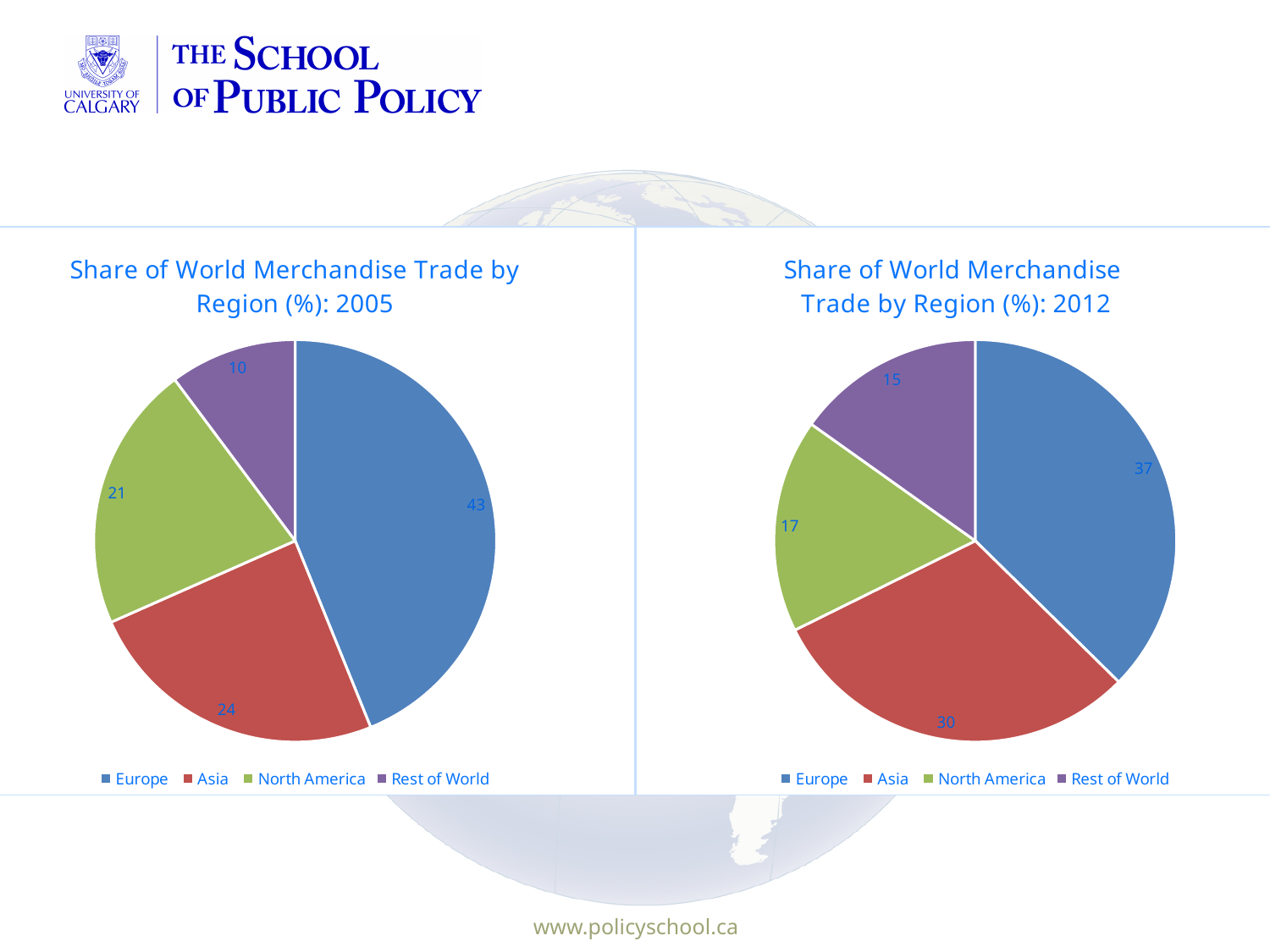
In the 2012 chart, what is the value for Rest of World? 15 What kind of chart is the 2012 chart? Pie chart In the 2012 chart, what is the share of world merchandise trade for Asia? 30 How many regions are shown in the 2005 chart? 4 In the 2005 chart, what colour is the Asia slice? Red In the 2012 chart, what is the difference between the shares of Asia and North America? 13 In the 2005 chart, what is the share of world merchandise trade for Europe? 43 In the 2005 chart, what is the difference between the shares of Europe and Asia? 19 In the 2005 chart, which region has the smallest share? Rest of World In the 2005 chart, which region has the largest share? Europe In the 2012 chart, which is larger, the share for North America or the share for Rest of World? North America In the 2012 chart, which region has the smallest share? Rest of World